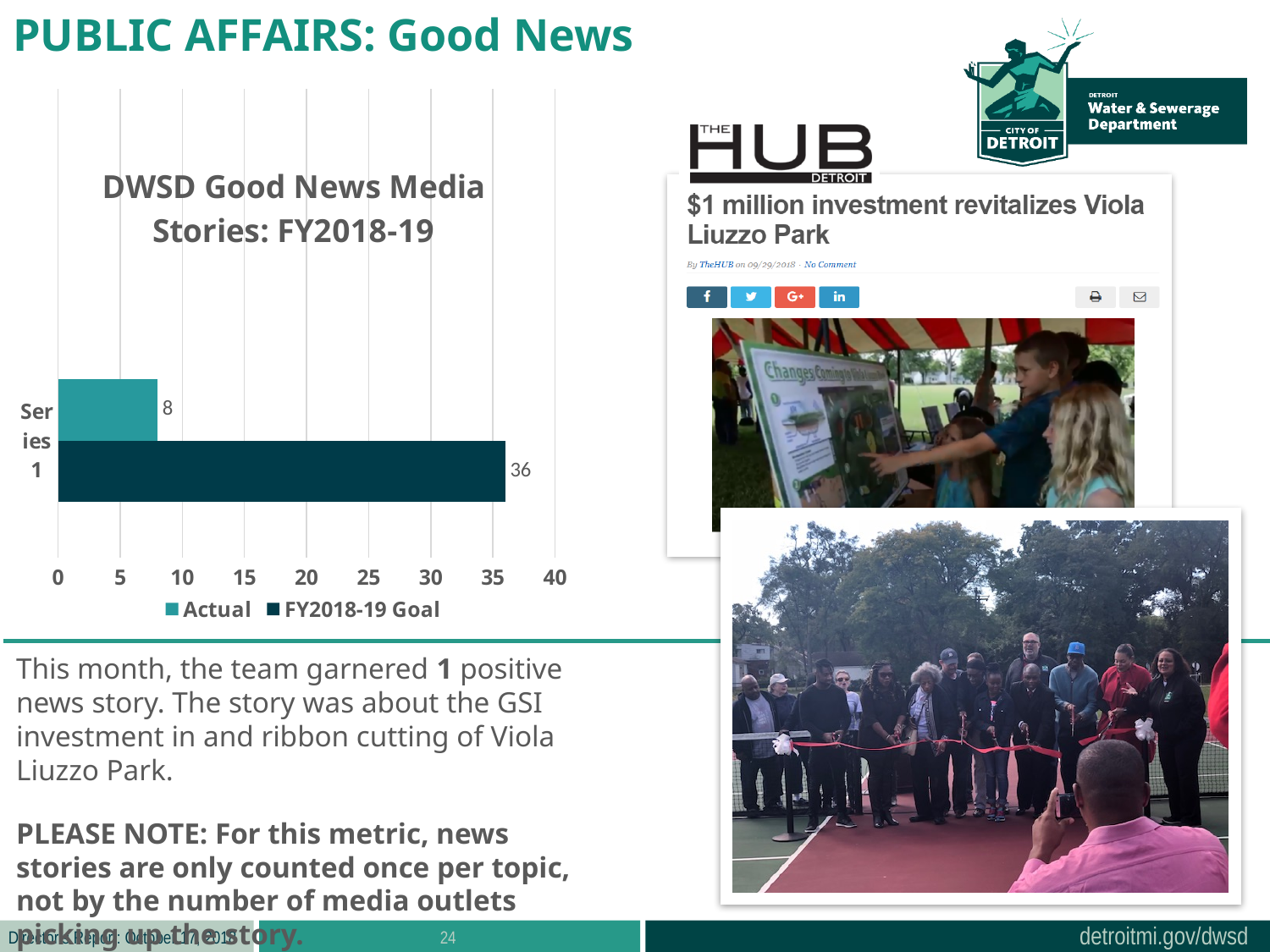
How many series does the chart legend list? 2 Which series has the lowest value in the chart? Actual What is the value of the Actual bar in the chart? 8 Which series has the highest value in the chart? FY2018-19 Goal What is the difference between the FY2018-19 Goal value and the Actual value? 28 Which series has the larger value, Actual or FY2018-19 Goal? FY2018-19 Goal What is the title of the chart? DWSD Good News Media Stories: FY2018-19 Is the value for FY2018-19 Goal greater or less than 30? greater What kind of chart is shown on the slide? bar chart Is the value for Actual greater or less than 10? less What is the value of the FY2018-19 Goal bar in the chart? 36 What is the maximum value shown on the chart's horizontal axis? 40